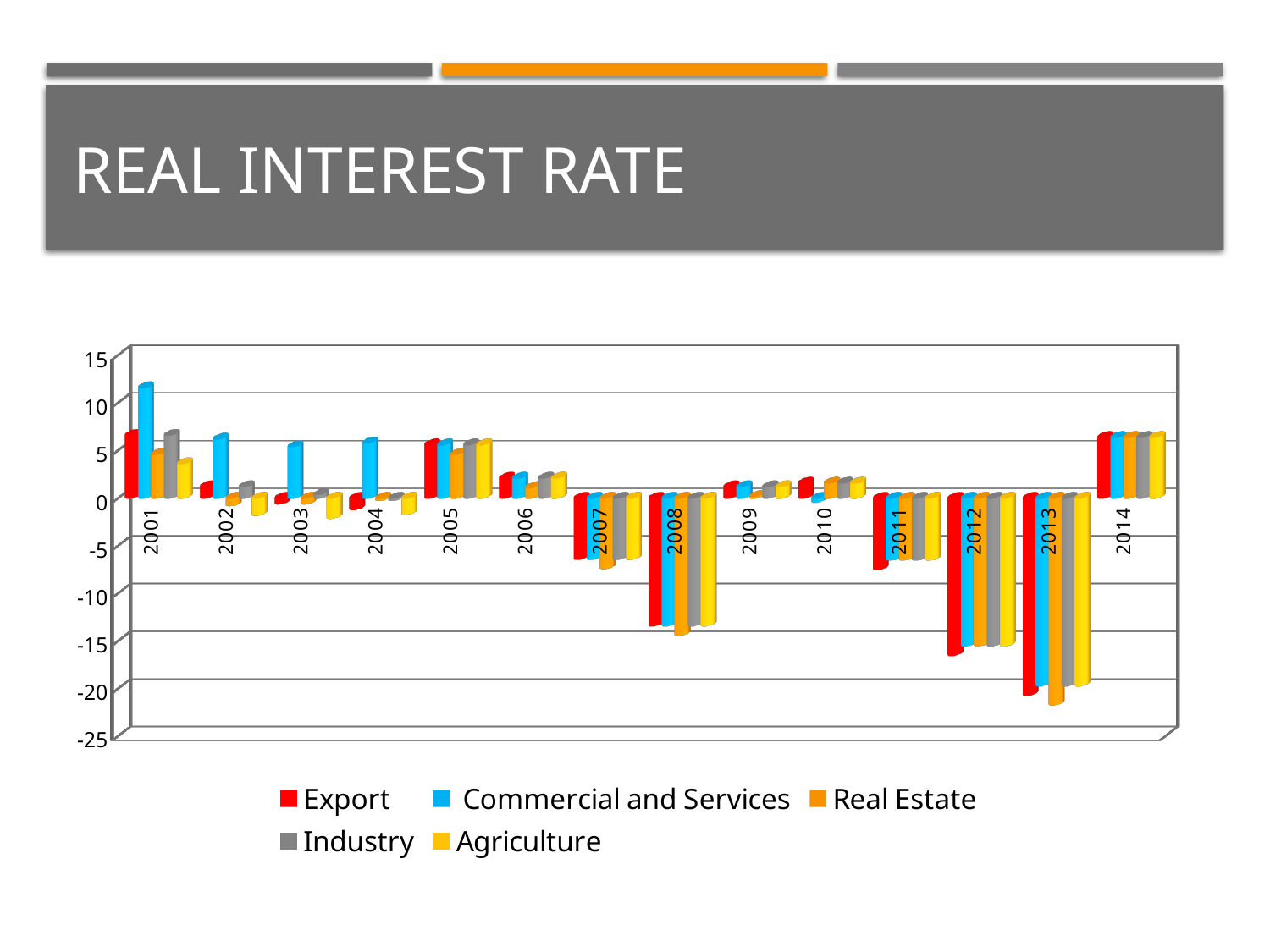
Is the value for Commercial and Services in 2001 greater or less than 10? greater In which year is the Export value lowest? 2013 Is the value for Export in 2013 greater or less than -15? less How many series does the legend list? 5 How many years are shown on the x axis? 14 What colour represents Export in the legend? red What kind of chart is shown on the slide? bar chart In 2001, which is larger: Export or Commercial and Services? Commercial and Services In which year is the Commercial and Services value highest? 2001 Which is larger: the Export value in 2008 or the Export value in 2012? 2008 Is the value for Agriculture in 2014 greater or less than 5? greater